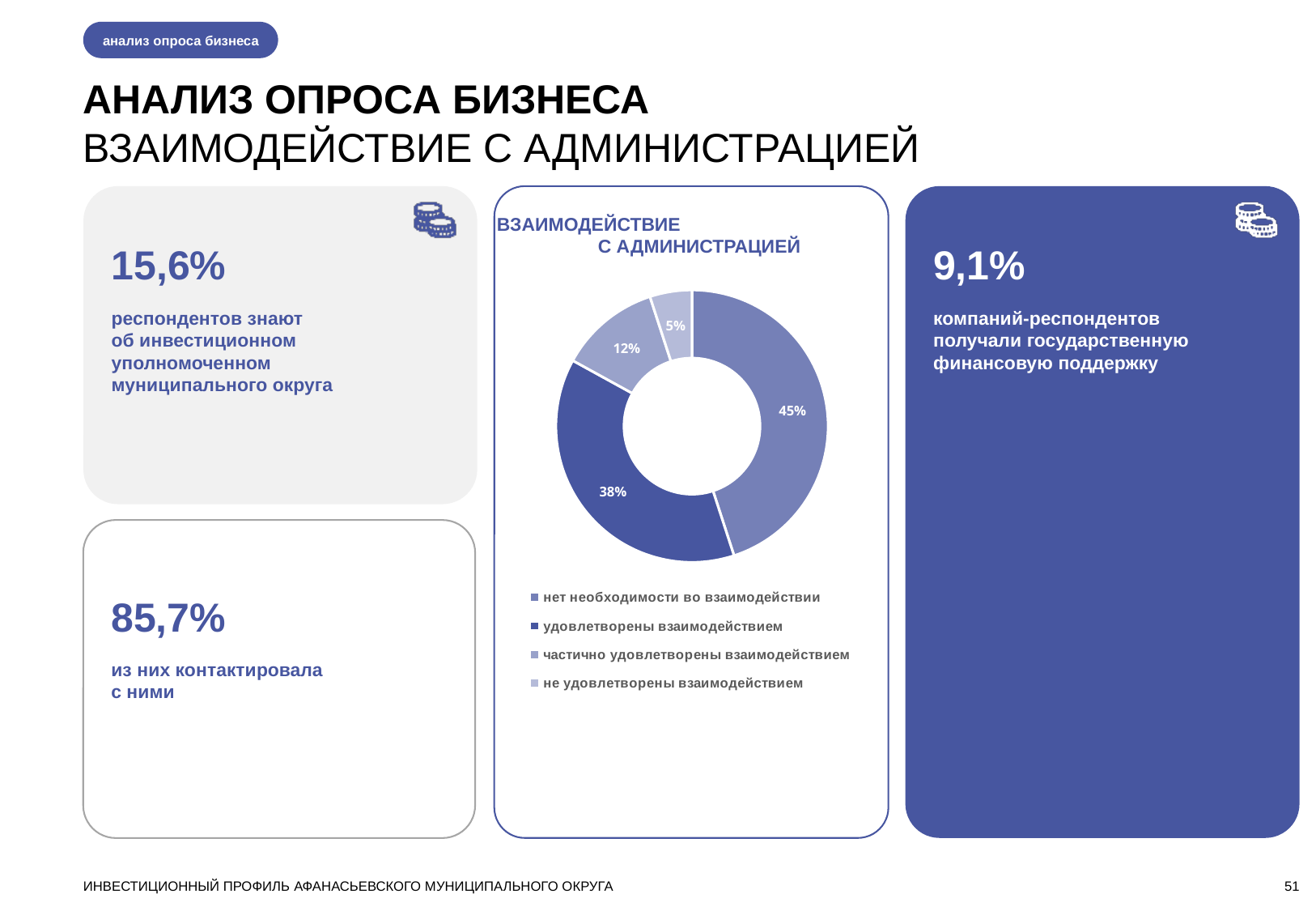
Какая доля респондентов частично удовлетворена взаимодействием с администрацией? 12% Какой тип диаграммы показан на слайде под заголовком «Взаимодействие с администрацией»? кольцевая (круговая) диаграмма Сколько категорий (секторов) показано на диаграмме «Взаимодействие с администрацией»? 4 Какая категория на диаграмме «Взаимодействие с администрацией» имеет наименьшую долю? не удовлетворены взаимодействием Сколько пунктов перечислено в легенде диаграммы «Взаимодействие с администрацией»? 4 Какая доля респондентов не удовлетворена взаимодействием с администрацией? 5% Какая доля респондентов на диаграмме «Взаимодействие с администрацией» ответила «нет необходимости во взаимодействии»? 45% Что больше на диаграмме: доля частично удовлетворённых или доля не удовлетворённых взаимодействием? частично удовлетворены взаимодействием Какая категория на диаграмме «Взаимодействие с администрацией» имеет наибольшую долю? нет необходимости во взаимодействии Как называется диаграмма на слайде? ВЗАИМОДЕЙСТВИЕ С АДМИНИСТРАЦИЕЙ Какая доля респондентов на диаграмме удовлетворена взаимодействием с администрацией? 38% На сколько процентных пунктов доля ответивших «нет необходимости во взаимодействии» больше доли удовлетворённых взаимодействием? 7